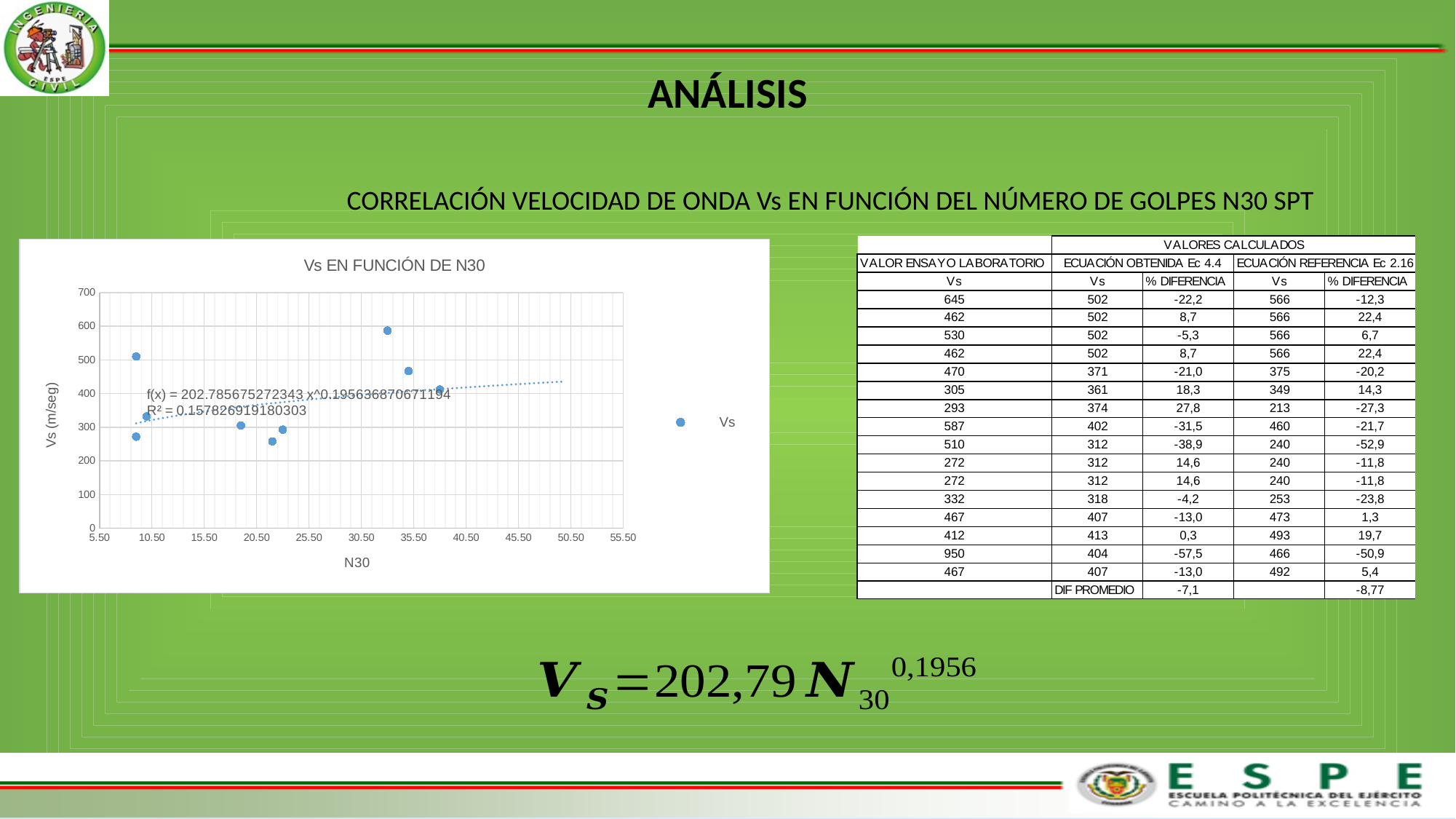
What is the title of the chart? Vs EN FUNCIÓN DE N30 What is the maximum value shown on the vertical axis? 700 What R² value is printed on the chart? R² = 0.157826919180303 What kind of chart is shown on the slide? scatter chart Is the Vs value of the point plotted near N30 = 33 greater or less than 500? greater Is the lowest plotted Vs value greater or less than 300? less How many series does the chart legend list? 1 Is the highest plotted Vs value greater or less than 500? greater What is the largest tick value shown on the horizontal axis? 55.50 Does the dotted trendline rise or fall as N30 increases? rises